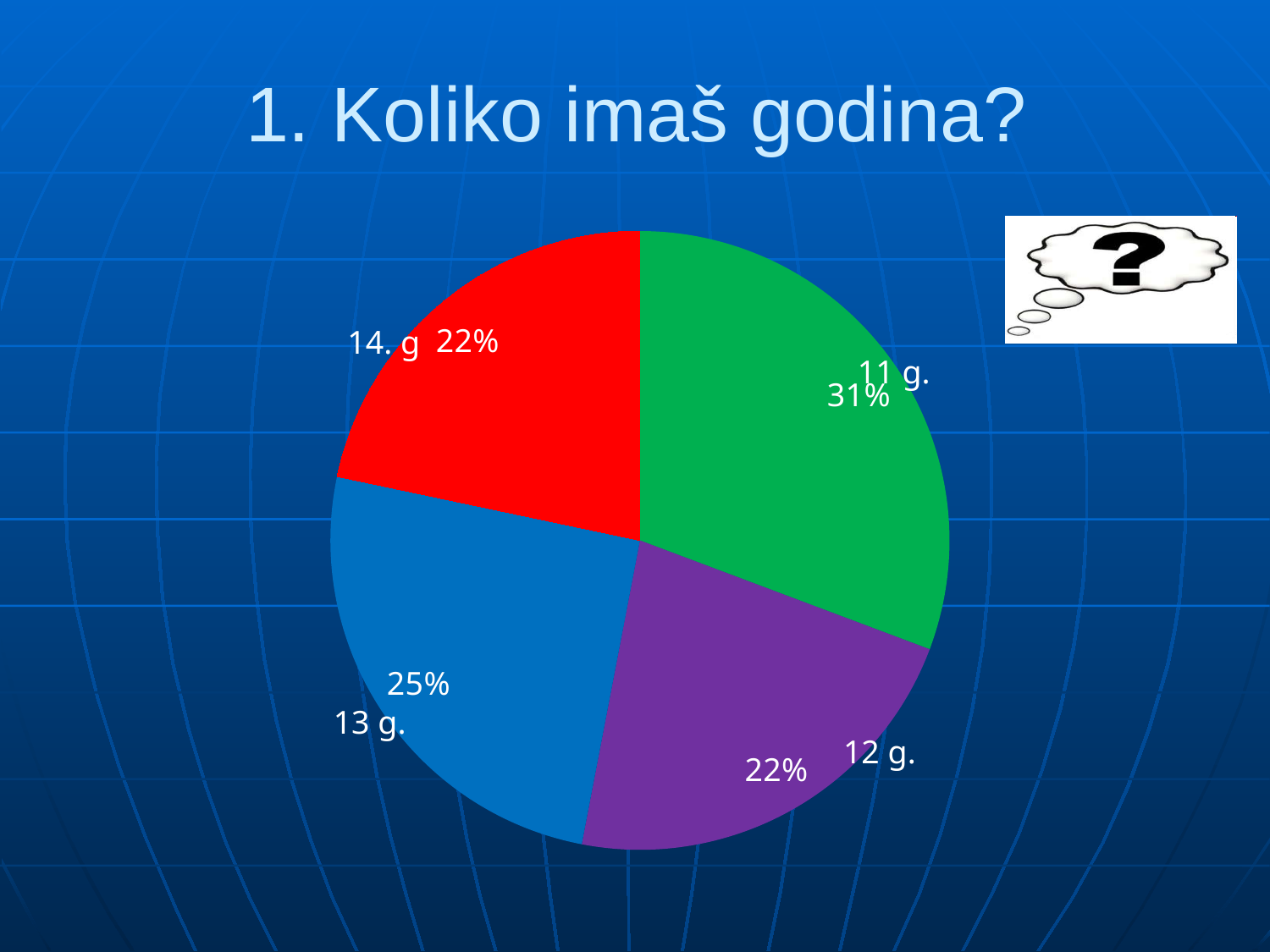
What is the difference in percentage points between the 11 g. slice and the 13 g. slice? 6 Which slice is larger, 11 g. or 13 g.? 11 g. How many slices does the pie chart have? 4 Which slice is larger, 13 g. or 14. g? 13 g. What percentage is shown for the 14. g slice? 22% What is the title of the slide containing the chart? 1. Koliko imaš godina? What is the difference in percentage points between the 13 g. slice and the 12 g. slice? 3 What percentage is shown for the 13 g. slice? 25% What share of the pie does the 11 g. slice represent? 31% Which age group has the largest share of the pie? 11 g. What kind of chart is shown on the slide? Pie chart What percentage is shown for the 12 g. slice? 22%